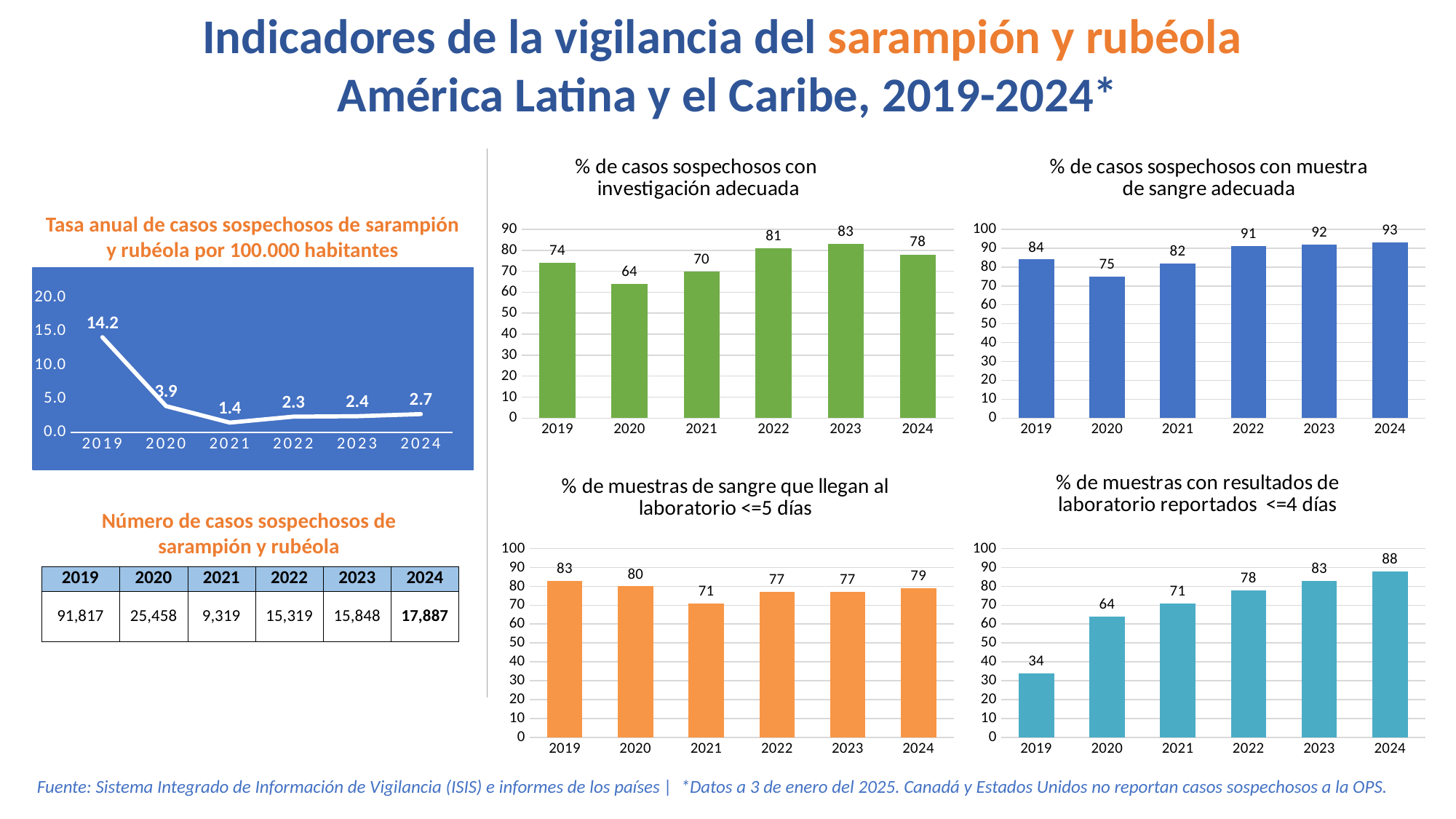
In the chart 'Tasa anual de casos sospechosos de sarampión y rubéola por 100.000 habitantes', what is the value for 2019? 14.2 In the chart '% de casos sospechosos con muestra de sangre adecuada', what is the difference between the values for 2024 and 2020? 18 In the chart '% de muestras con resultados de laboratorio reportados <=4 días', what is the value for 2019? 34 In the chart '% de casos sospechosos con investigación adecuada', what is the value for 2022? 81 In the chart '% de muestras de sangre que llegan al laboratorio <=5 días', what is the value for 2021? 71 In the chart '% de muestras con resultados de laboratorio reportados <=4 días', do the values rise or fall from 2019 to 2024? Rise In the chart '% de muestras de sangre que llegan al laboratorio <=5 días', which is larger, the value for 2019 or the value for 2024? 2019 In the chart '% de casos sospechosos con muestra de sangre adecuada', how many years are plotted? 6 What kind of chart is 'Tasa anual de casos sospechosos de sarampión y rubéola por 100.000 habitantes'? Line chart In the chart 'Tasa anual de casos sospechosos de sarampión y rubéola por 100.000 habitantes', which year has the lowest value? 2021 What kind of chart is '% de muestras con resultados de laboratorio reportados <=4 días'? Bar chart In the chart '% de casos sospechosos con investigación adecuada', which year has the highest value? 2023